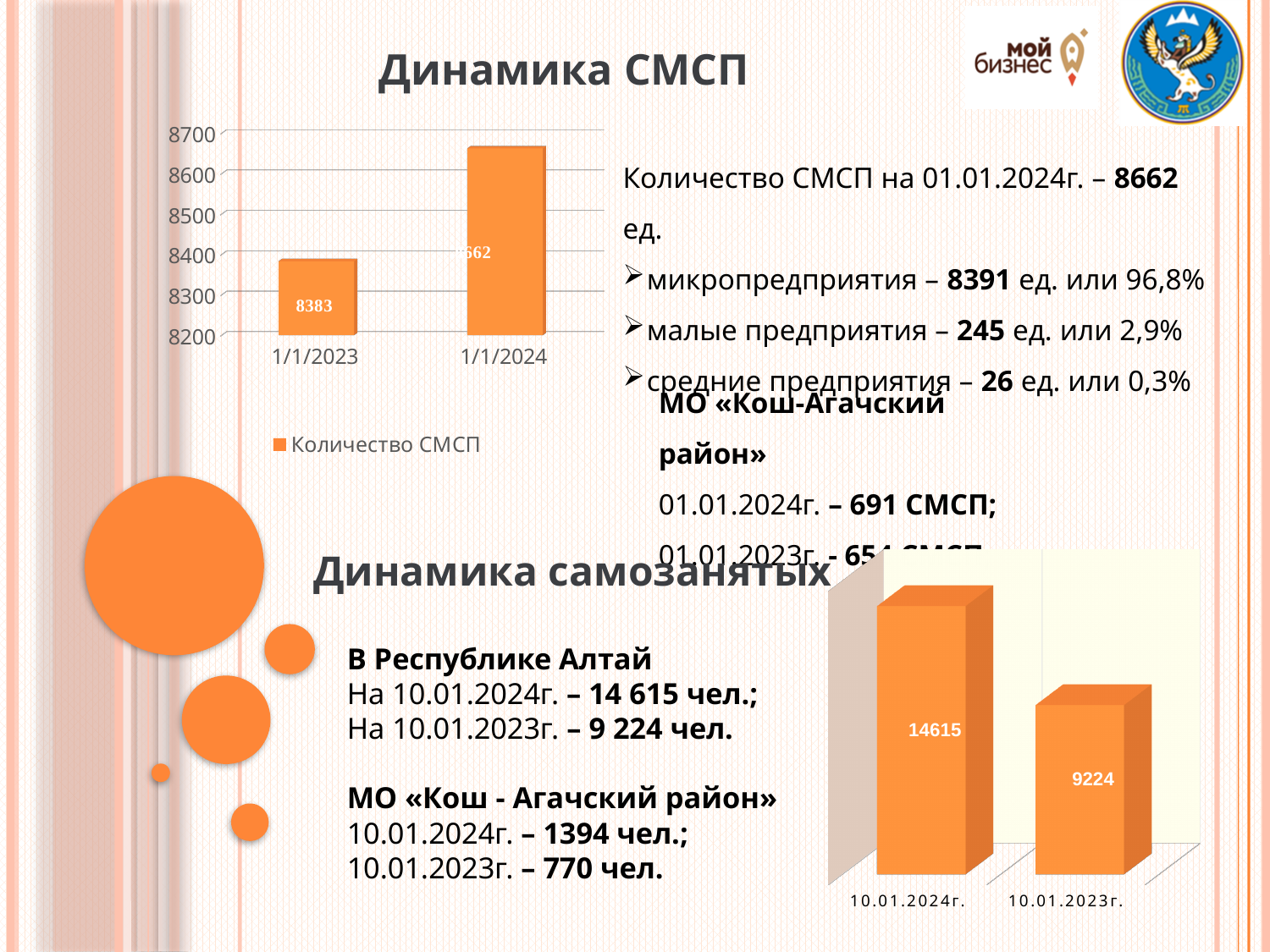
In the top-left chart 'Динамика СМСП', what is the value for 1/1/2024? 8662 In the bottom-right chart, what is the value for 10.01.2023г.? 9224 In the bottom-right chart, what is the value for 10.01.2024г.? 14615 What type of chart is the bottom-right chart on the slide? bar chart In the top-left chart 'Динамика СМСП', which date has the higher value? 1/1/2024 In the top-left chart 'Динамика СМСП', what is the legend entry? Количество СМСП In the top-left chart 'Динамика СМСП', how many series does the legend list? 1 In the bottom-right chart, how many bars are plotted? 2 In the top-left chart 'Динамика СМСП', is the value for 1/1/2023 greater or less than 8400? less In the top-left chart 'Динамика СМСП', what is the difference between the 1/1/2024 and 1/1/2023 values? 279 In the top-left chart 'Динамика СМСП', what is the value for 1/1/2023? 8383 In the bottom-right chart, what is the difference between the 10.01.2024г. and 10.01.2023г. values? 5391